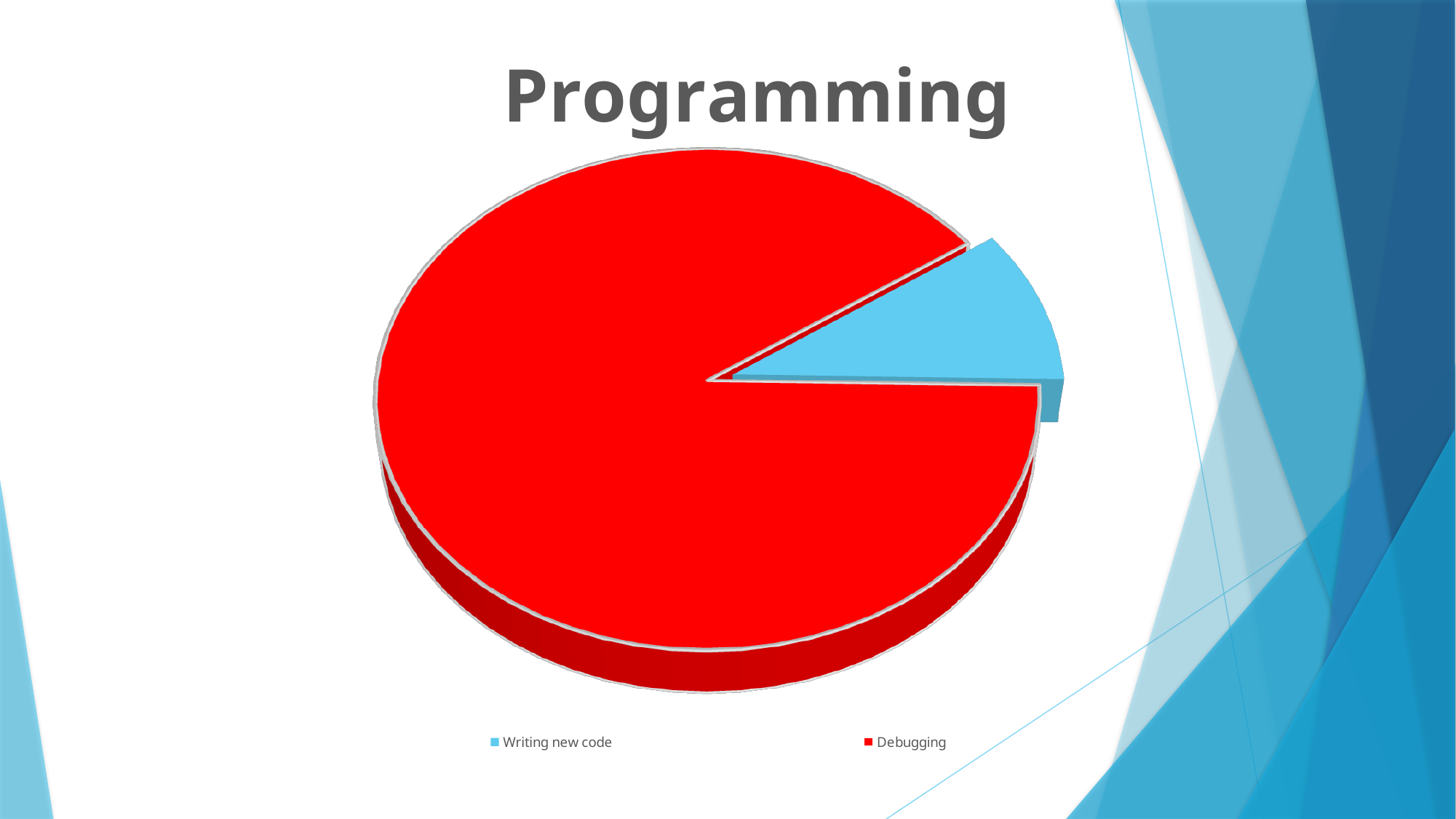
What kind of chart is shown on the slide? pie chart How many slices does the pie chart have? 2 Does the Debugging slice take up more or less than half of the pie? more Which category has the smallest slice of the pie? Writing new code Which category has the largest slice of the pie? Debugging Which category is shown in blue in the legend? Writing new code What is the title of the chart? Programming Which slice is larger, Writing new code or Debugging? Debugging What colour is the Debugging slice? red